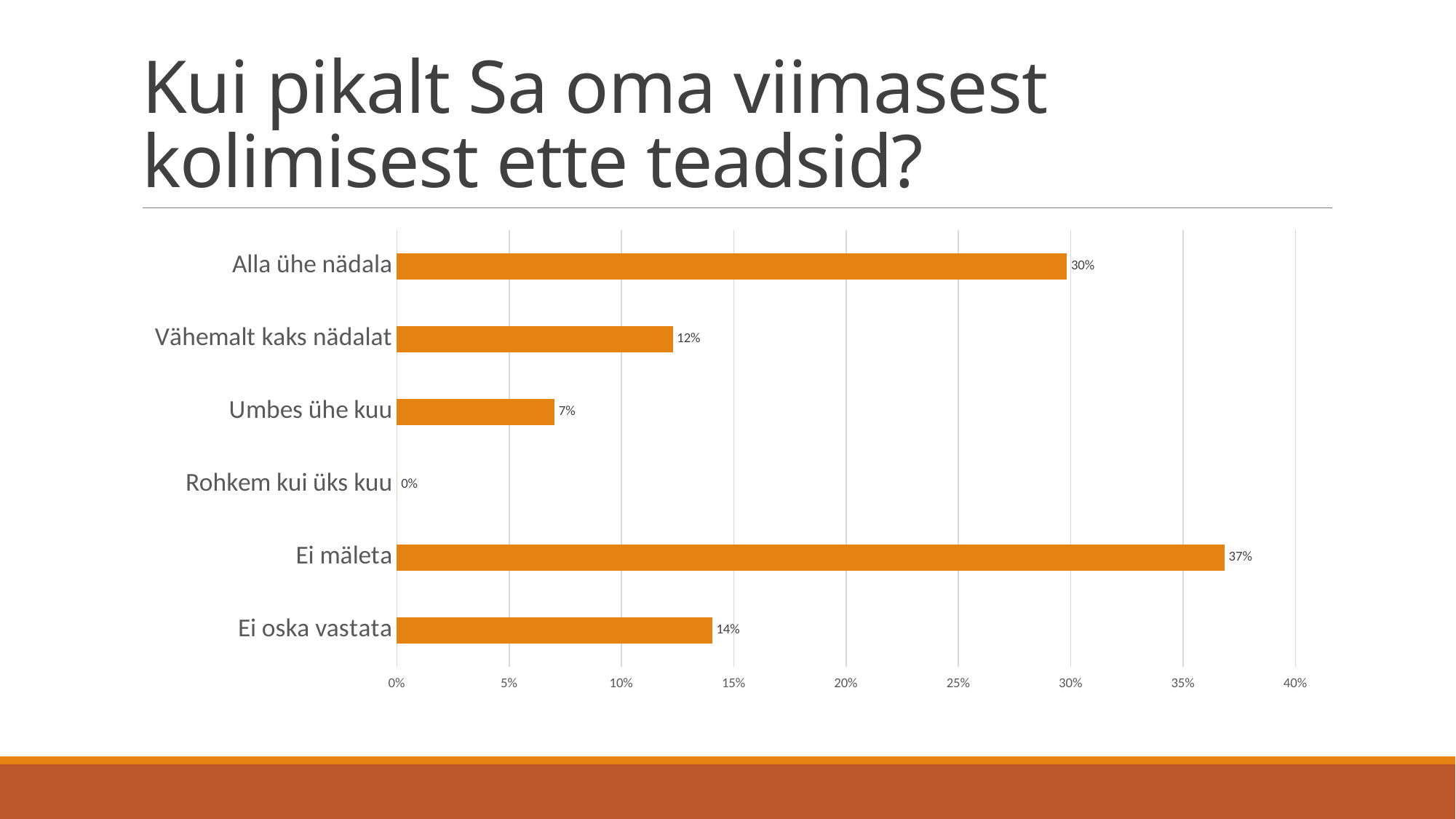
What is the value for "Vähemalt kaks nädalat"? 12% What is the value for "Alla ühe nädala"? 30% What is the value for "Ei oska vastata"? 14% What is the difference between the values for "Ei mäleta" and "Alla ühe nädala"? 7% What kind of chart is shown on the slide? Bar chart What is the value for "Rohkem kui üks kuu"? 0% How many categories are shown in the chart? 6 Which category has the highest value? Ei mäleta Which is larger, the value for "Vähemalt kaks nädalat" or the value for "Ei oska vastata"? Ei oska vastata Which category has the lowest value? Rohkem kui üks kuu What is the value for "Umbes ühe kuu"? 7% What is the title of the slide? Kui pikalt Sa oma viimasest kolimisest ette teadsid?